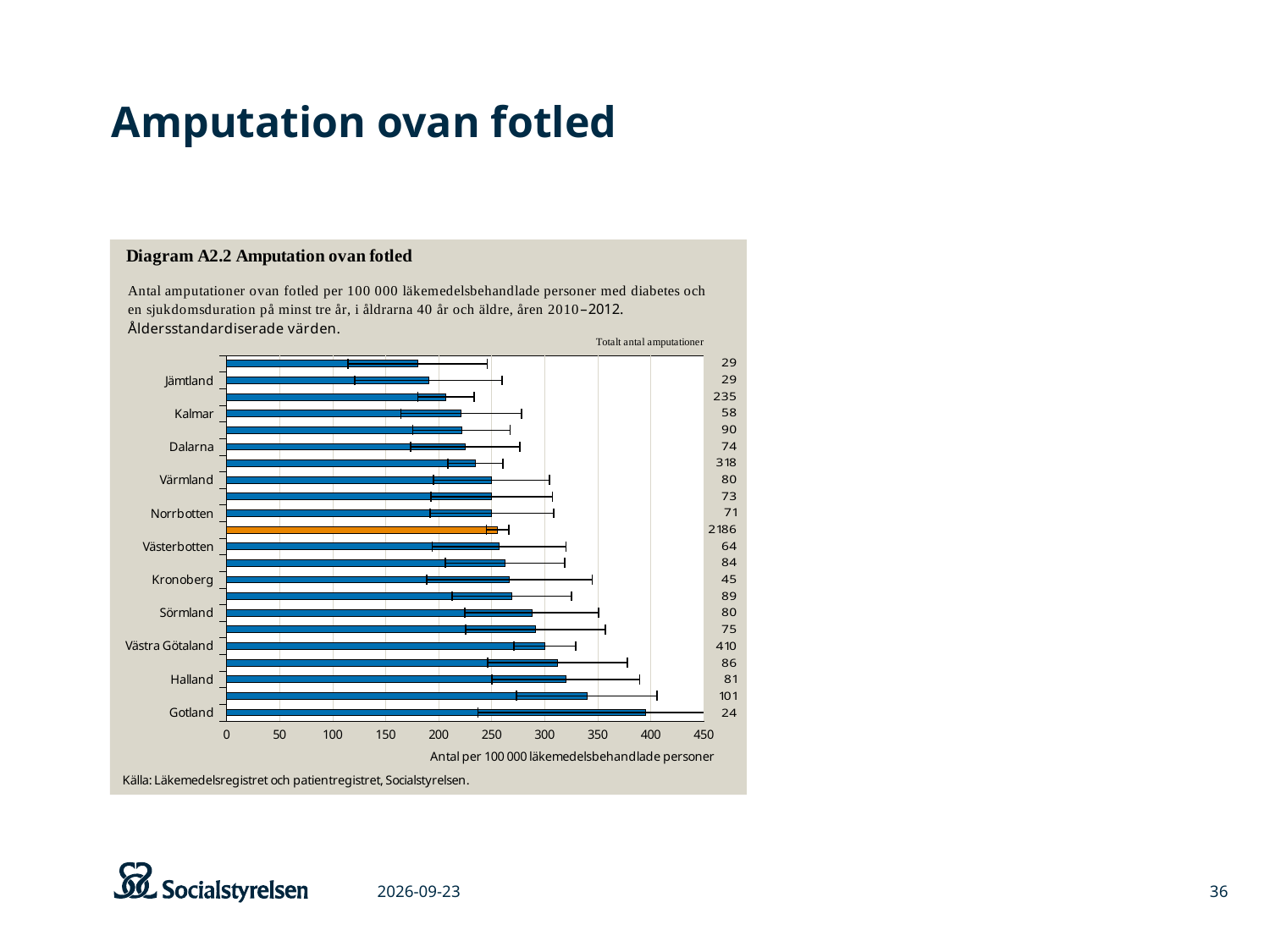
Which has the larger value, Gotland or Jämtland? Gotland What type of chart is shown in Diagram A2.2? bar chart Is the value for Jämtland greater or less than 200? less In the 'Totalt antal amputationer' column, what is the total number of amputations listed for Gotland? 24 Is the value for Kronoberg greater or less than 250? greater What is the x-axis title of the chart? Antal per 100 000 läkemedelsbehandlade personer Which has the larger value, Halland or Kalmar? Halland In the 'Totalt antal amputationer' column, what is the total number of amputations listed for Västra Götaland? 410 Is the value for Halland greater or less than 300? greater Which labelled region has the longest bar in the chart? Gotland How many bars are plotted in the chart? 22